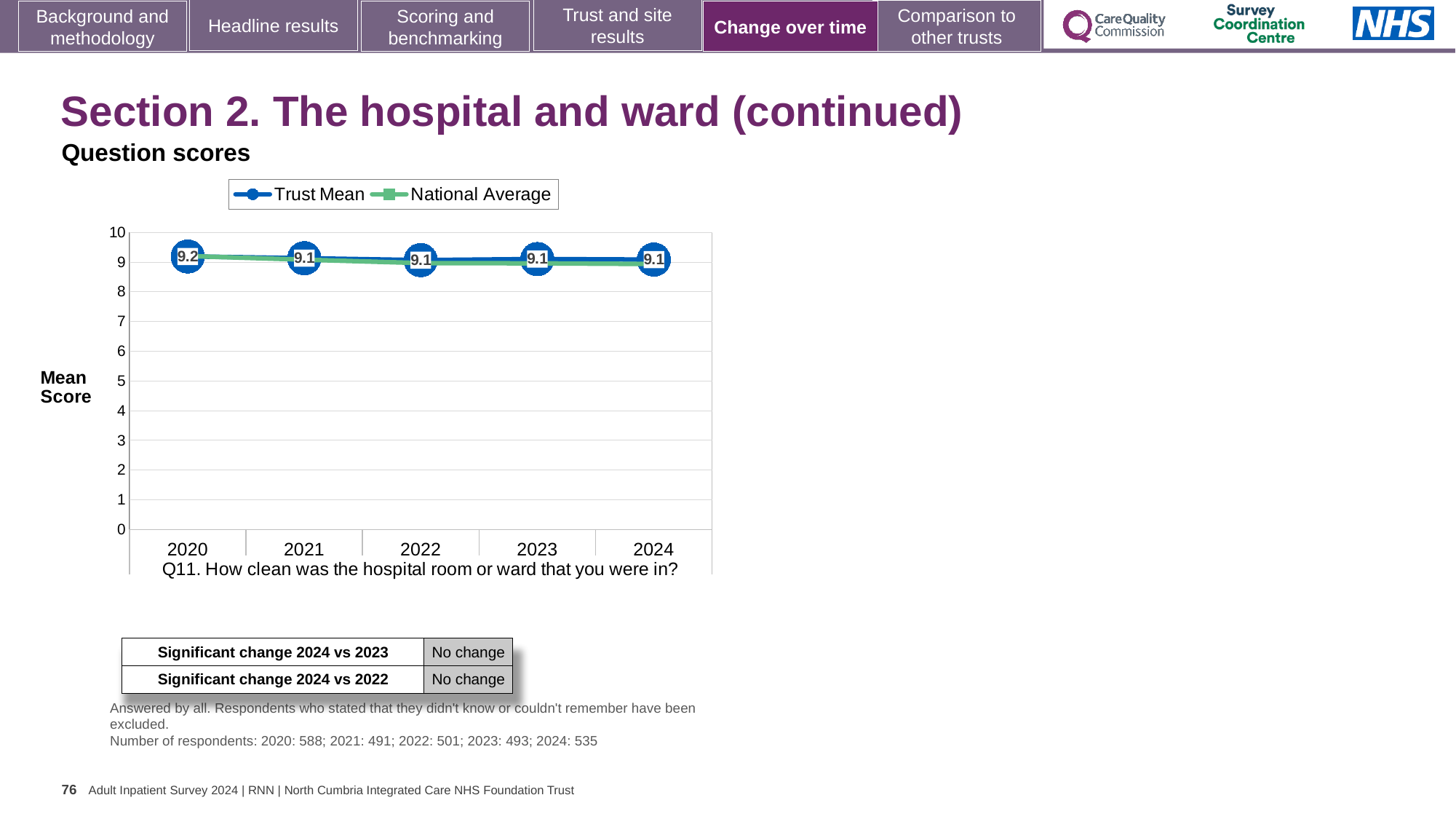
What is the label on the y axis of the chart? Mean Score How many series does the chart legend list? 2 What is the Trust Mean score for 2024 on the Q11 chart? 9.1 What is the difference between the Trust Mean score in 2020 and in 2024? 0.1 What is the Trust Mean score for 2020 on the Q11 chart? 9.2 Is the National Average value for 2024 greater or less than 8? greater Is the Trust Mean score for 2020 larger or smaller than the Trust Mean score for 2023? larger How many years are shown on the x axis of the chart? 5 What kind of chart is shown on the slide? line chart What is the Trust Mean score for 2022 on the Q11 chart? 9.1 In which year is the Trust Mean score highest on the Q11 chart? 2020 Do the Trust Mean values rise or fall from 2020 to 2024? fall